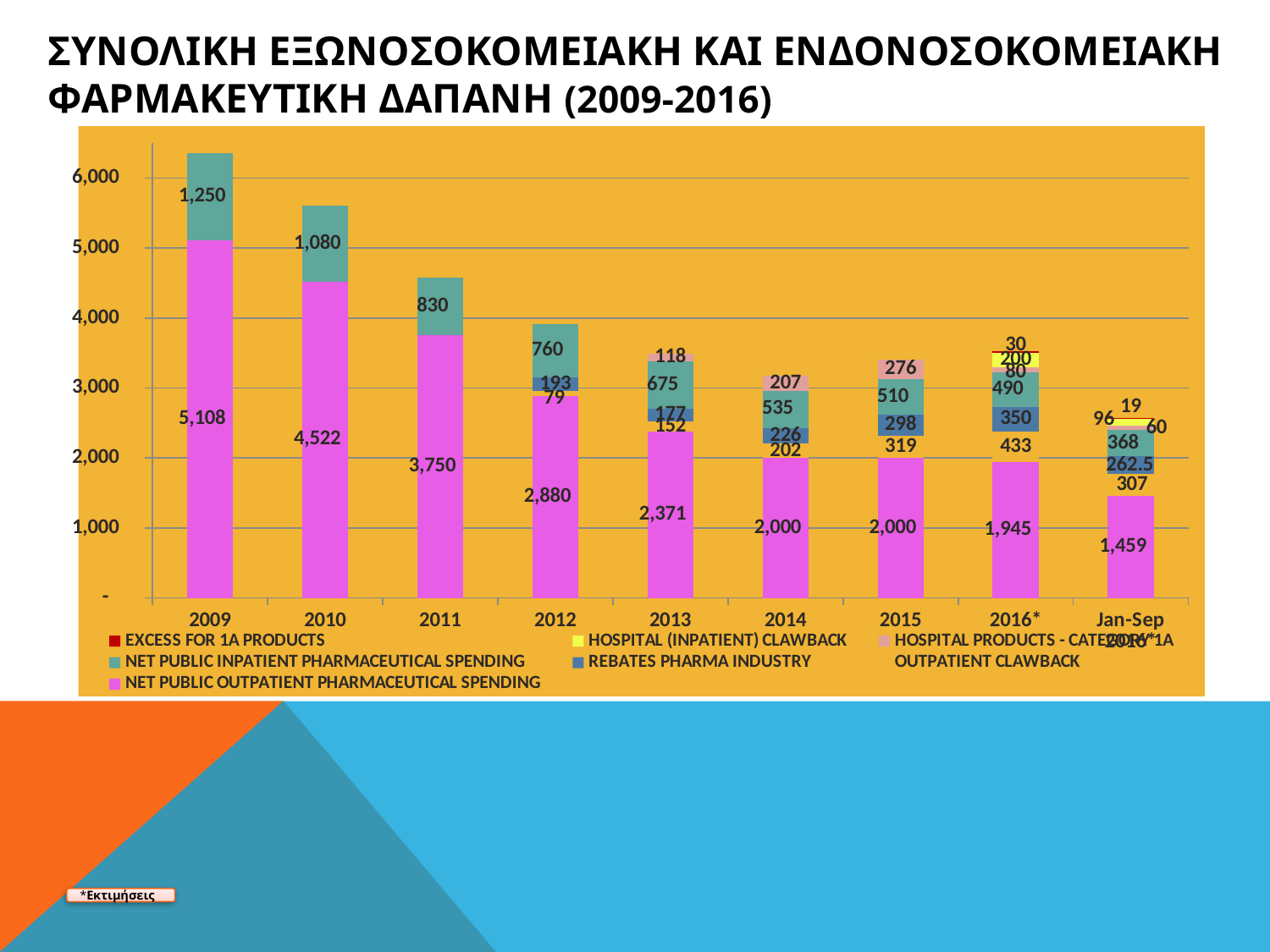
How many series does the legend list? 7 What kind of chart is shown on the slide? Stacked bar chart Is the total of the stacked bar for 2009 greater or less than 6,000? greater Which year has the highest NET PUBLIC OUTPATIENT PHARMACEUTICAL SPENDING? 2009 Which period has the lowest NET PUBLIC OUTPATIENT PHARMACEUTICAL SPENDING? Jan-Sep 2016* What is the REBATES PHARMA INDUSTRY value for 2015? 298 What is the NET PUBLIC INPATIENT PHARMACEUTICAL SPENDING value for 2011? 830 What is the total of the stacked bar for 2010? 5,602 Which is larger, the NET PUBLIC INPATIENT PHARMACEUTICAL SPENDING in 2012 or in 2013? 2012 How many periods are shown on the x axis? 9 What is the NET PUBLIC OUTPATIENT PHARMACEUTICAL SPENDING value for 2009? 5,108 What is the difference in NET PUBLIC OUTPATIENT PHARMACEUTICAL SPENDING between 2009 and 2010? 586